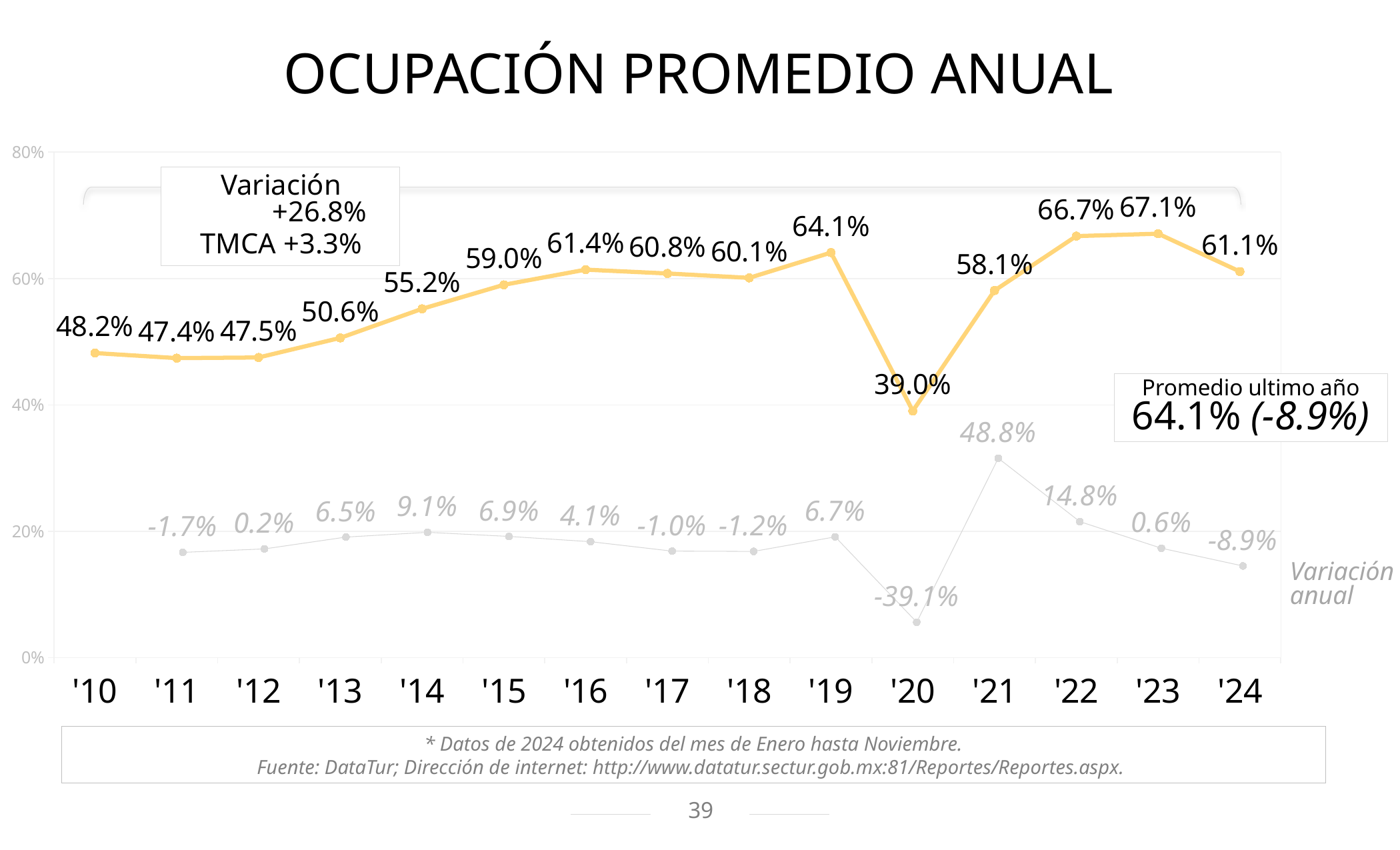
What TMCA value is shown in the annotation box on the chart? +3.3% What is the 'Variación anual' value shown for '21? 48.8% How many years are plotted on the x axis? 15 Which year has the higher average annual occupancy, '22 or '24? '22 Which year has the highest average annual occupancy? '23 What is the difference in average annual occupancy between '23 and '20? 28.1 percentage points Which year has the lowest average annual occupancy? '20 What is the average annual occupancy shown for '20? 39.0% What is the average annual occupancy shown for '19? 64.1% Does the average annual occupancy rise or fall from '16 to '18? Fall What kind of chart is shown on the slide? Line chart What is the average annual occupancy shown for '24? 61.1%